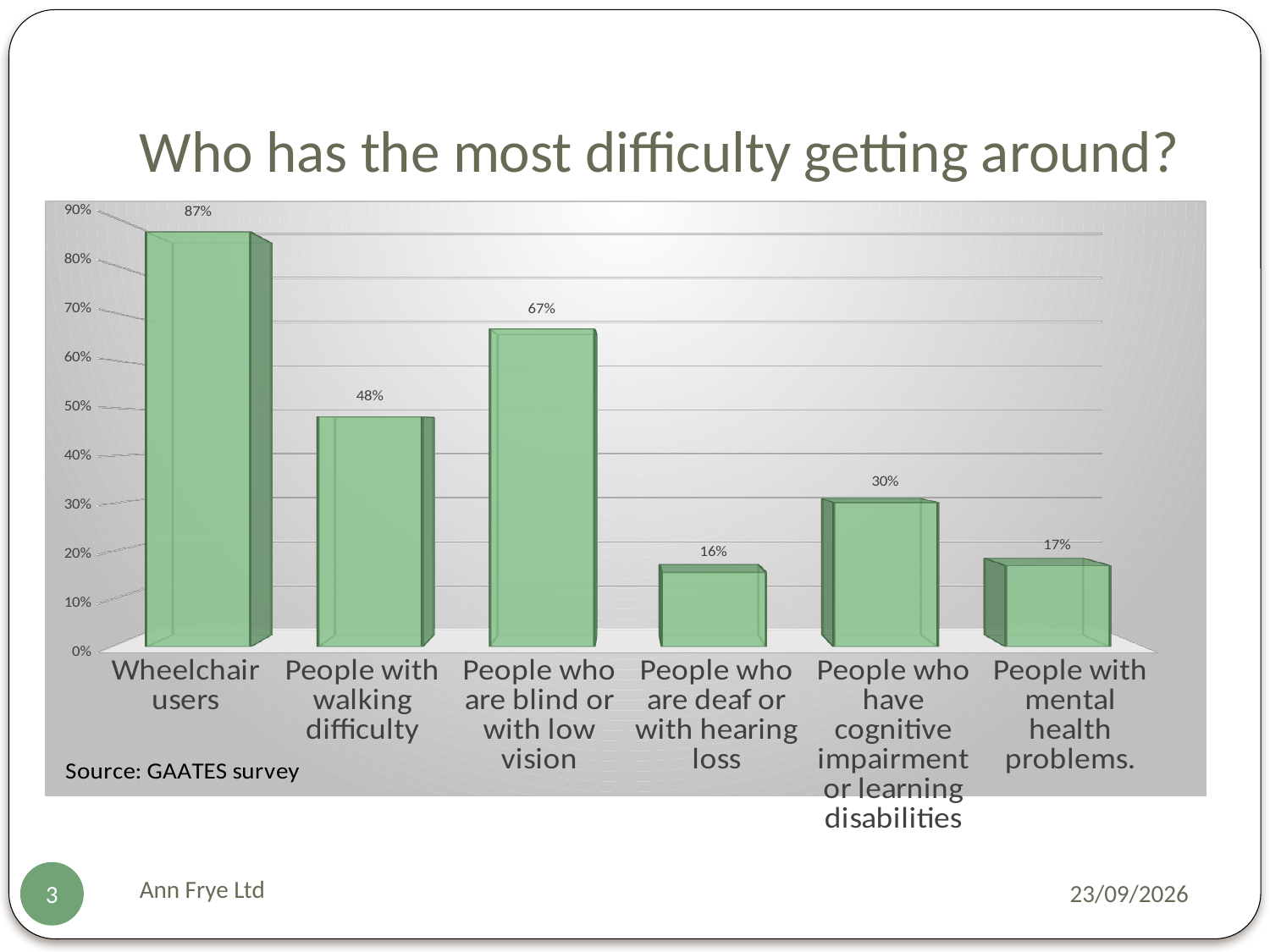
What source is cited for the chart data? GAATES survey What is the value for People who are blind or with low vision? 67% How many categories are shown in the chart? 6 What kind of chart is shown on the slide? Bar chart What is the difference between the values for Wheelchair users and People with walking difficulty? 39% Which category has the highest value? Wheelchair users What is the difference between the values for People who are blind or with low vision and People who have cognitive impairment or learning disabilities? 37% What is the value for Wheelchair users? 87% What is the value for People who are deaf or with hearing loss? 16% What is the value for People with mental health problems? 17% Which category has the lowest value? People who are deaf or with hearing loss Which is larger: the value for People with walking difficulty or the value for People who have cognitive impairment or learning disabilities? People with walking difficulty